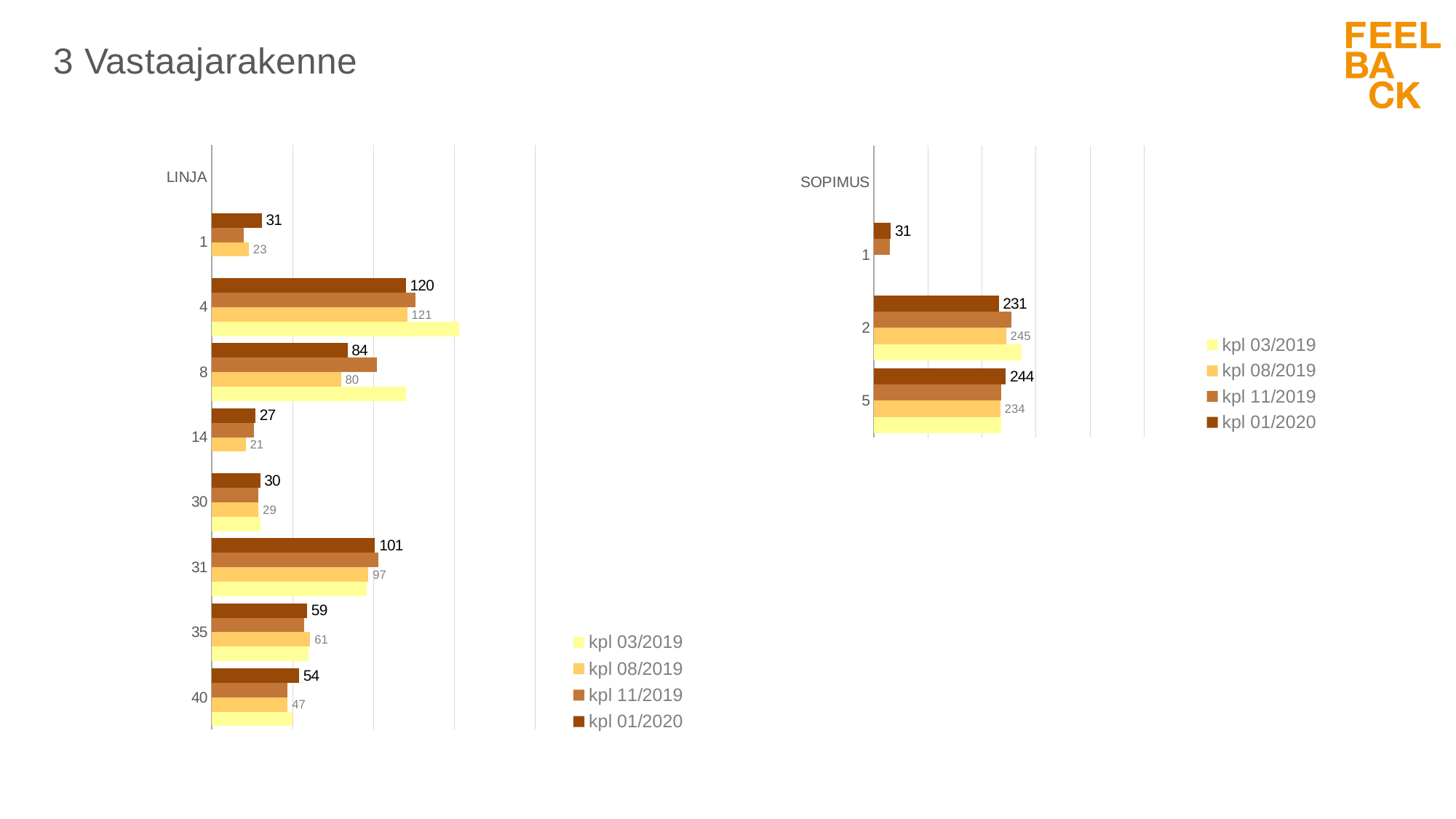
In the SOPIMUS chart, what is the difference between the kpl 01/2020 values for categories 5 and 2? 13 What type of chart is the LINJA chart? Bar chart In the LINJA chart, what is the kpl 01/2020 value for category 4? 120 In the LINJA chart, which category has the lowest kpl 08/2019 value? 14 In the LINJA chart, what is the difference between the kpl 01/2020 values for categories 31 and 8? 17 In the LINJA chart, which is larger for category 35: the kpl 01/2020 value or the kpl 08/2019 value? kpl 08/2019 In the SOPIMUS chart, what is the kpl 01/2020 value for category 5? 244 How many categories are shown in the LINJA chart? 8 In the SOPIMUS chart, what is the kpl 08/2019 value for category 2? 245 How many series does the legend of the SOPIMUS chart list? 4 In the LINJA chart, which category has the highest kpl 01/2020 value? 4 In the LINJA chart, what is the kpl 08/2019 value for category 31? 97